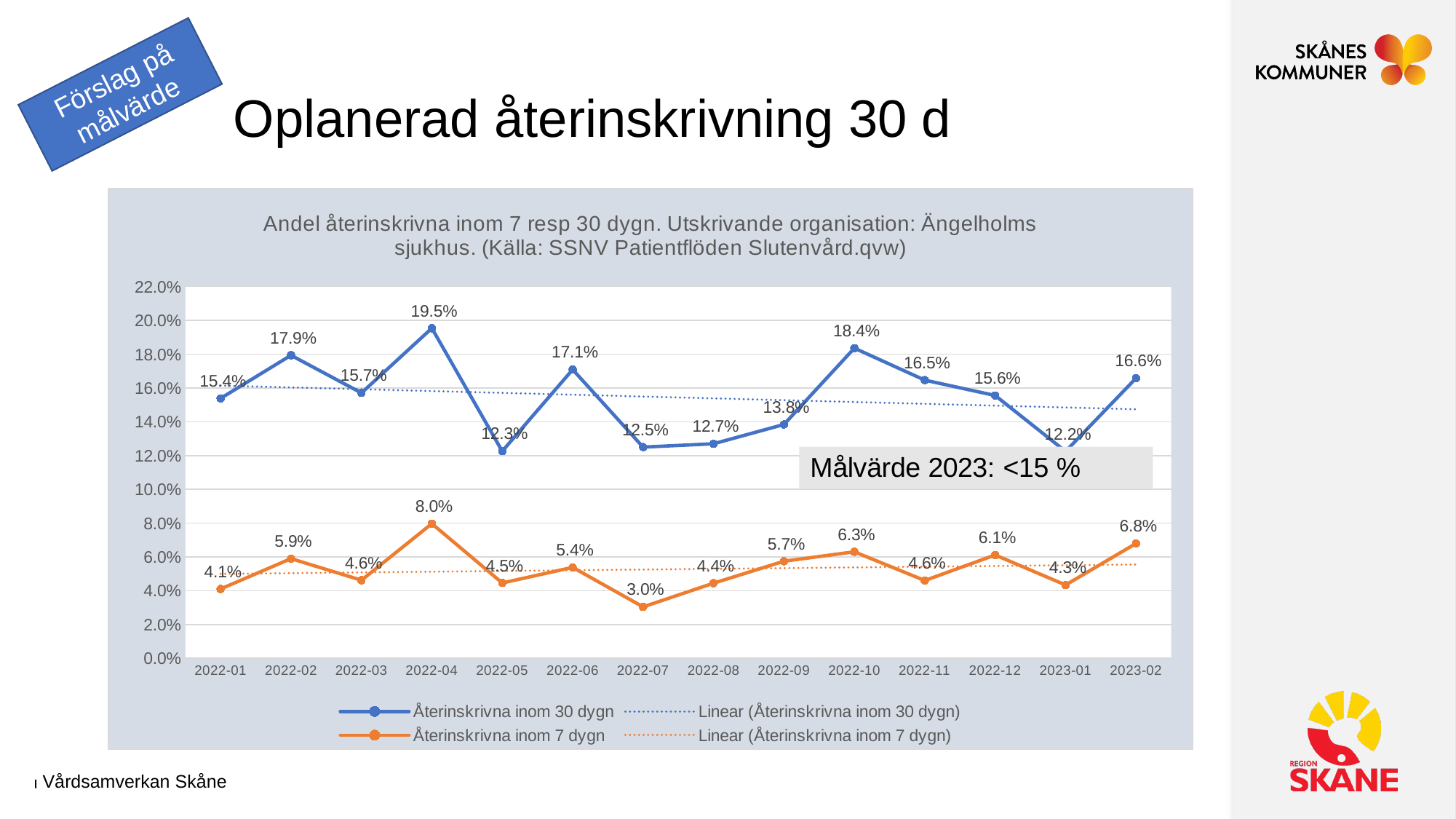
How many entries does the legend list? 4 How many months are plotted on the x axis? 14 What is the value for Återinskrivna inom 7 dygn in 2022-07? 3.0% In which month is Återinskrivna inom 7 dygn lowest? 2022-07 What is the value for Återinskrivna inom 30 dygn in 2022-04? 19.5% What kind of chart is shown? Line chart In which month is Återinskrivna inom 30 dygn highest? 2022-04 Which is larger for Återinskrivna inom 30 dygn: 2022-02 or 2022-10? 2022-10 What is the difference between Återinskrivna inom 30 dygn in 2022-04 and in 2022-05? 7.2 percentage points In which month is Återinskrivna inom 7 dygn highest? 2022-04 What target value (Målvärde) for 2023 is stated on the chart? <15 % What is the value for Återinskrivna inom 7 dygn in 2023-02? 6.8%